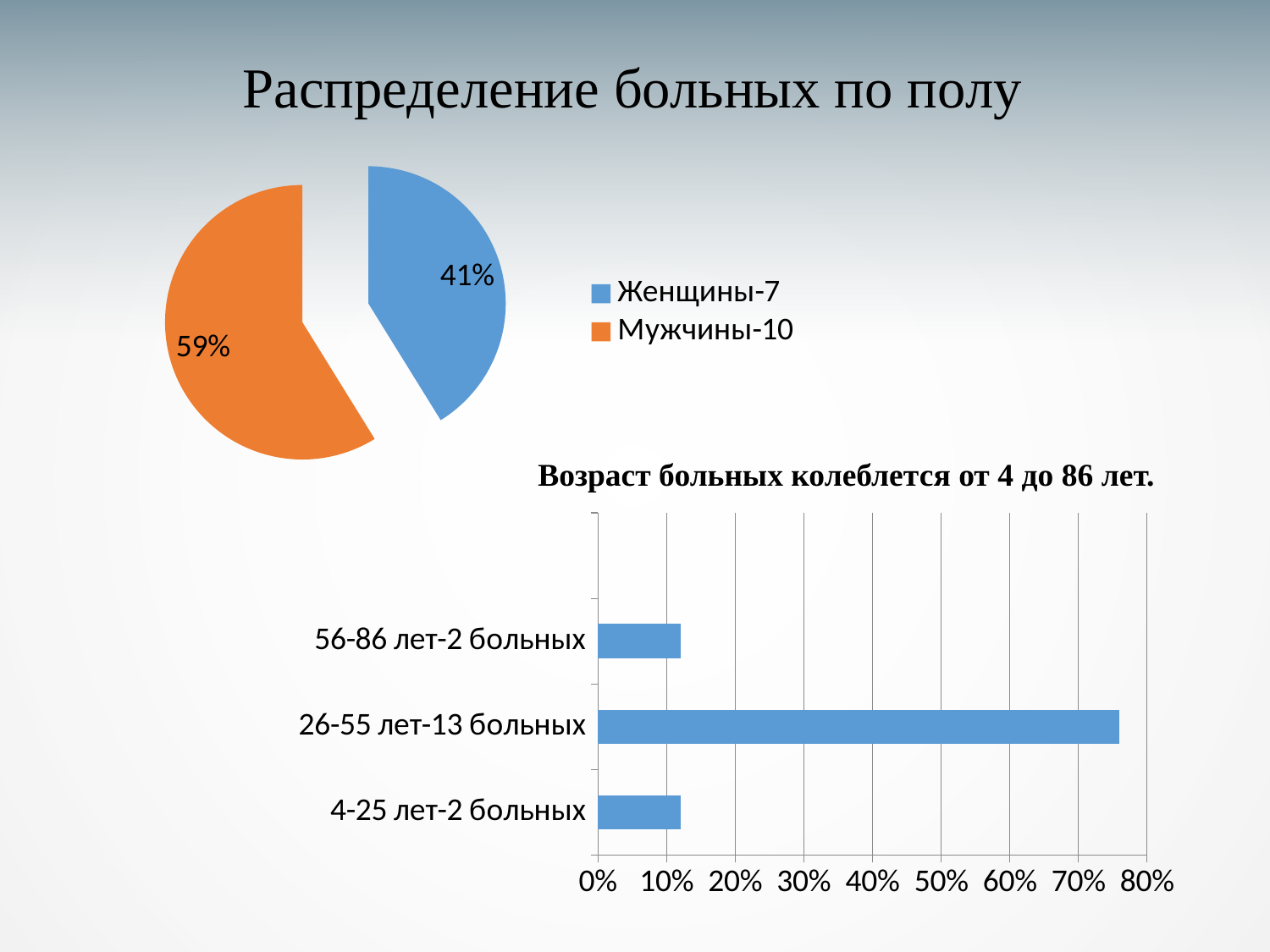
In the pie chart at the top of the slide, what share is shown for Мужчины-10? 59% In the pie chart at the top of the slide, what share is shown for Женщины-7? 41% In the bar chart at the bottom of the slide, is the value for 26-55 лет-13 больных greater or less than 70%? greater What type of chart is the chart at the bottom of the slide? Bar chart In the bar chart at the bottom of the slide, which category has the longest bar? 26-55 лет-13 больных In the pie chart at the top of the slide, which category has the larger slice? Мужчины-10 In the pie chart at the top of the slide, what is the difference in percentage points between the Мужчины-10 slice and the Женщины-7 slice? 18% In the bar chart at the bottom of the slide, how many categories are shown? 3 In the pie chart at the top of the slide, what colour is the Женщины-7 slice? Blue What is the title of the chart at the bottom of the slide? Возраст больных колеблется от 4 до 86 лет. In the pie chart at the top of the slide, how many slices are there? 2 In the bar chart at the bottom of the slide, is the value for 56-86 лет-2 больных greater or less than 20%? less